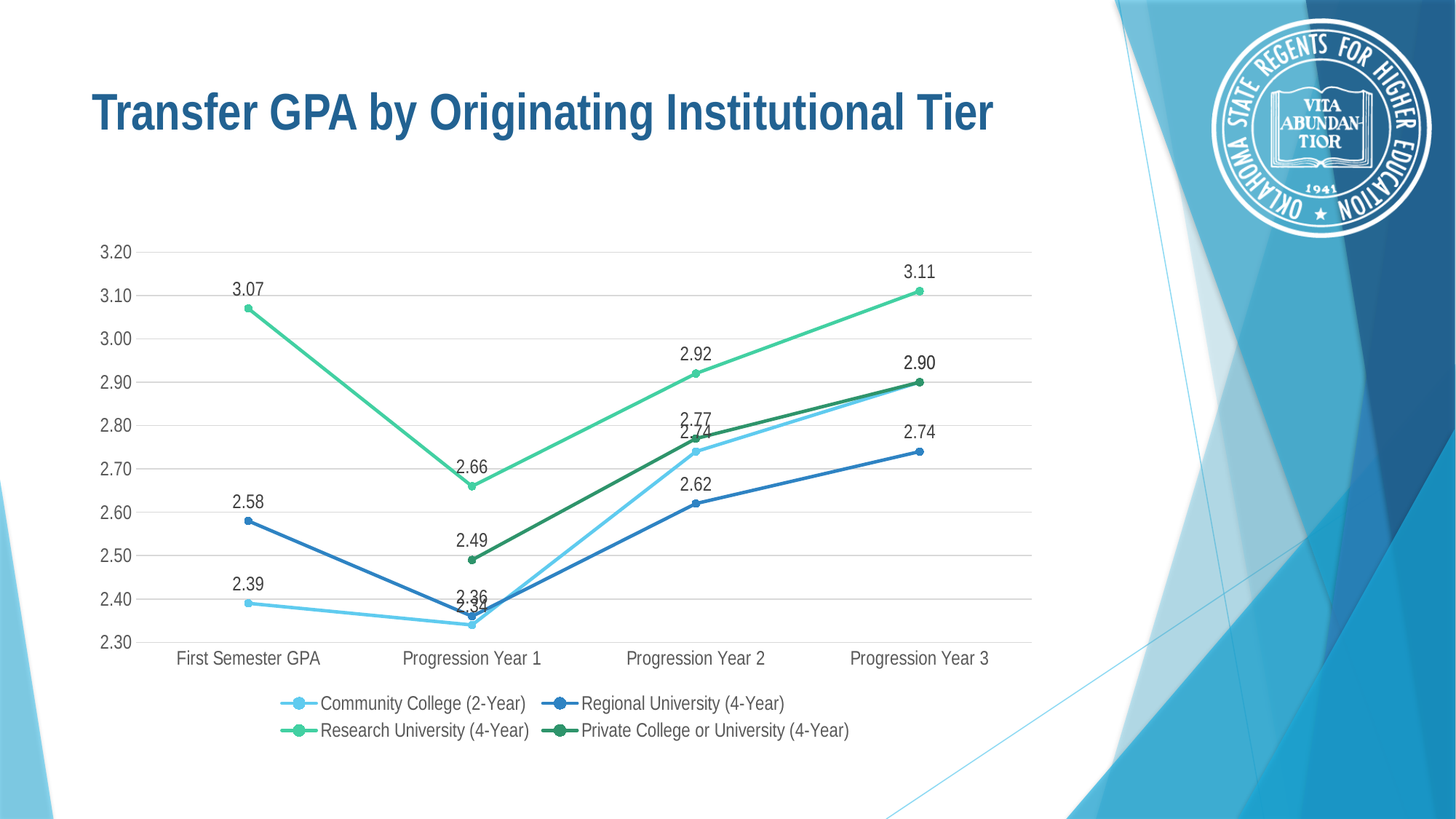
How many series does the legend list? 4 What is the Regional University (4-Year) value at Progression Year 3? 2.74 What is the difference between the Research University (4-Year) and Regional University (4-Year) values at Progression Year 2? 0.30 What is the Research University (4-Year) value at First Semester GPA? 3.07 Is the Research University (4-Year) value at Progression Year 1 greater or less than 2.70? less At Progression Year 2, which is larger: the Community College (2-Year) value or the Regional University (4-Year) value? Community College (2-Year) What is the Community College (2-Year) value at Progression Year 2? 2.74 What is the Private College or University (4-Year) value at Progression Year 1? 2.49 How many categories are shown on the x axis? 4 Which series has the highest value at Progression Year 3? Research University (4-Year) What kind of chart is shown on the slide? line chart Which series has the lowest value at First Semester GPA? Community College (2-Year)